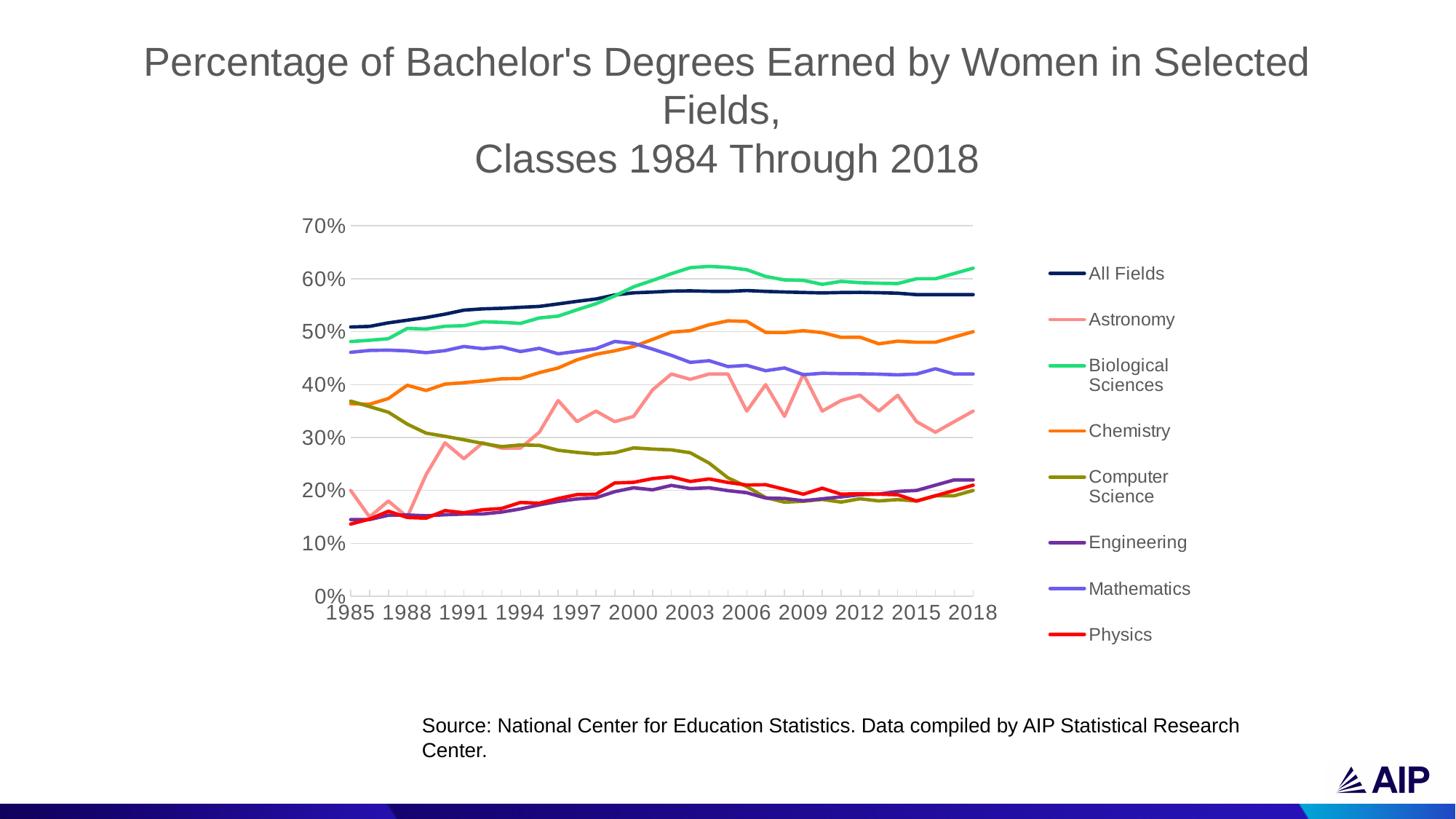
Does the Computer Science line rise or fall overall from 1985 to 2018? fall Is the value for Mathematics in 2018 greater or less than 50%? less How many series does the legend list? 8 What colour is the Physics line in the legend? red Which series has the highest value in 1985? All Fields Which series has the highest value in 2018? Biological Sciences In 1985, which is higher: Computer Science or Physics? Computer Science What kind of chart is shown on the slide? line chart Does the Biological Sciences line rise or fall overall from 1985 to 2018? rise Is the value for Physics in 1985 greater or less than 20%? less In 2018, which is higher: Chemistry or Mathematics? Chemistry Is the value for Biological Sciences in 2018 greater or less than 60%? greater